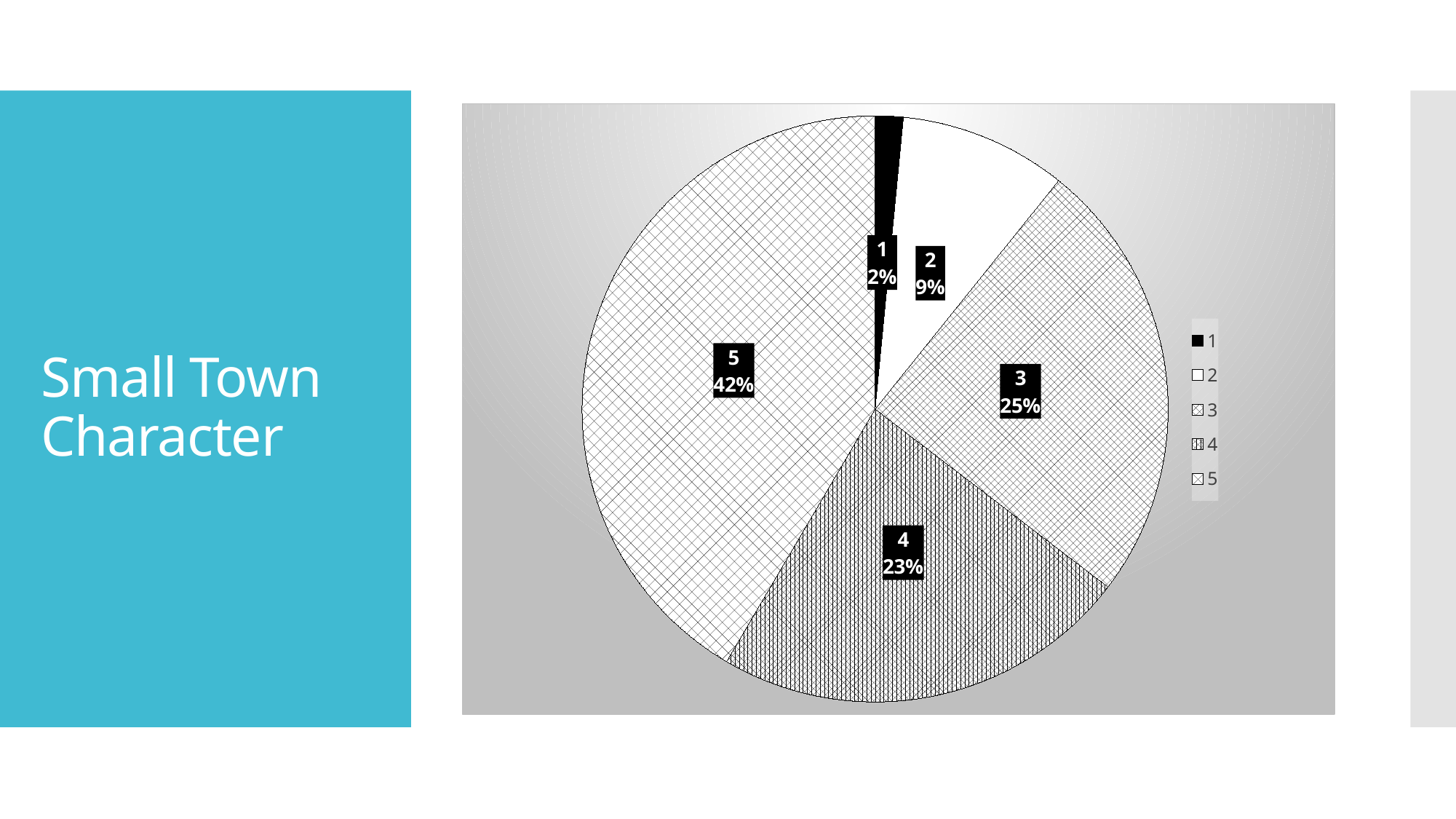
Which category has the largest slice of the pie? 5 How many slices does the pie chart have? 5 How many entries does the legend list? 5 What is the difference in percentage points between category 5 and category 4? 19 What share of the pie does category 3 have? 25% Which category has the smallest slice of the pie? 1 What share of the pie does category 1 have? 2% Which is larger, the slice for category 3 or the slice for category 2? 3 What kind of chart is shown on the slide? pie chart What share of the pie does category 2 have? 9% What share of the pie does category 5 have? 42% What share of the pie does category 4 have? 23%